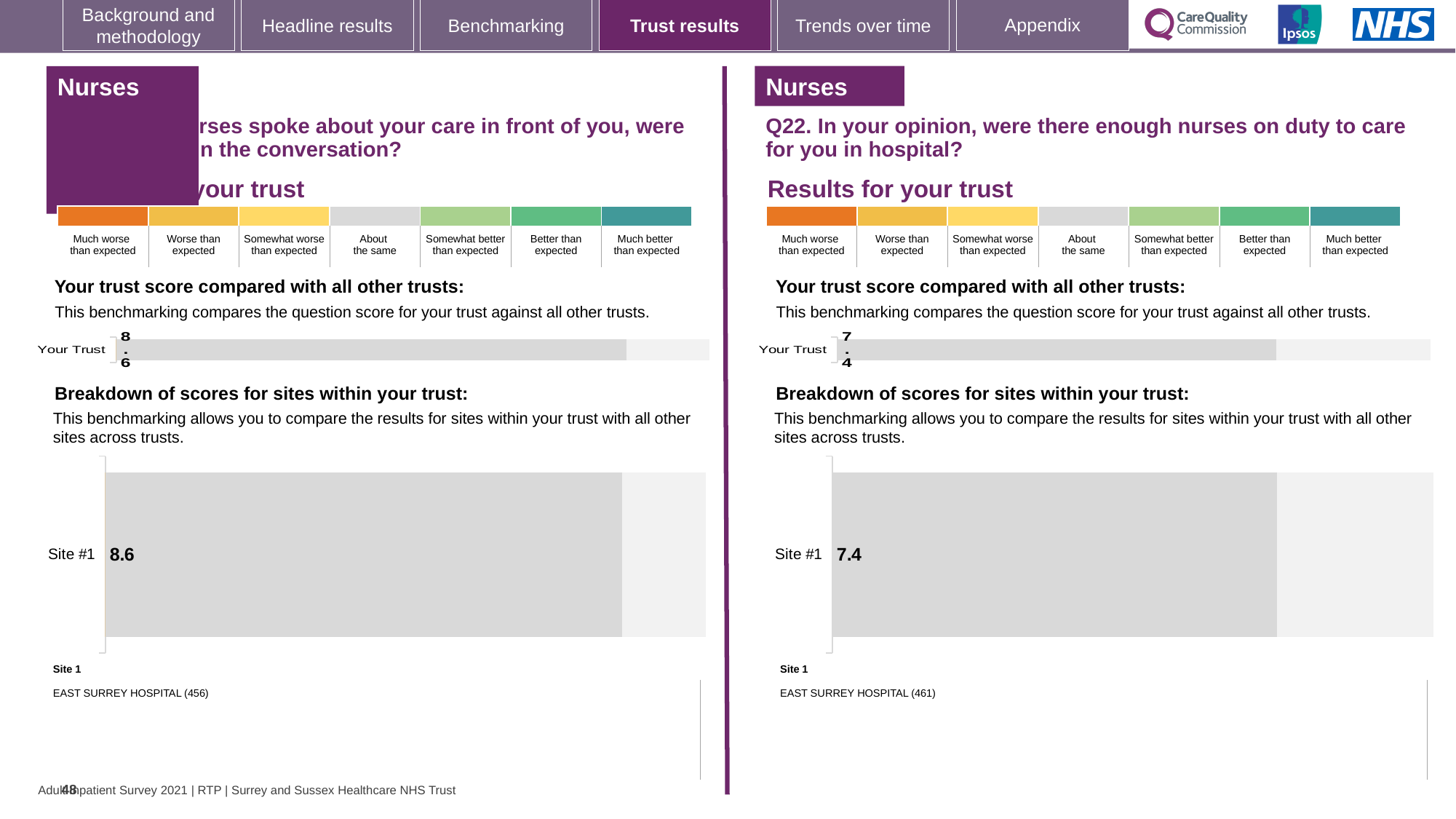
What is the difference between the Site #1 score on the left half of the slide and the Site #1 score on the right half (Q22)? 1.2 On the right half of the slide (Q22), is the Your Trust score greater or less than the Site #1 score, or are they equal? Equal On the right half of the slide (Q22), what is the score shown for Site #1 in the breakdown of scores chart? 7.4 Which hospital is listed as Site 1 below the breakdown chart on the right half of the slide (Q22)? EAST SURREY HOSPITAL (461) What kind of chart is used to show the Site #1 score on the right half of the slide (Q22)? Bar chart On the left half of the slide, what is the value shown for Your Trust in the trust score chart? 8.6 On the left half of the slide, what is the score shown for Site #1 in the breakdown of scores chart? 8.6 Which is larger: the Site #1 score on the left half of the slide or the Site #1 score on the right half (Q22)? Left half (8.6) On the right half of the slide (Q22), what is the value shown for Your Trust in the trust score chart? 7.4 How many sites are shown in the breakdown of scores chart on the left half of the slide? 1 How many sites are shown in the breakdown of scores chart on the right half of the slide (Q22)? 1 What is the category label on the bar in the trust score chart on the left half of the slide? Your Trust